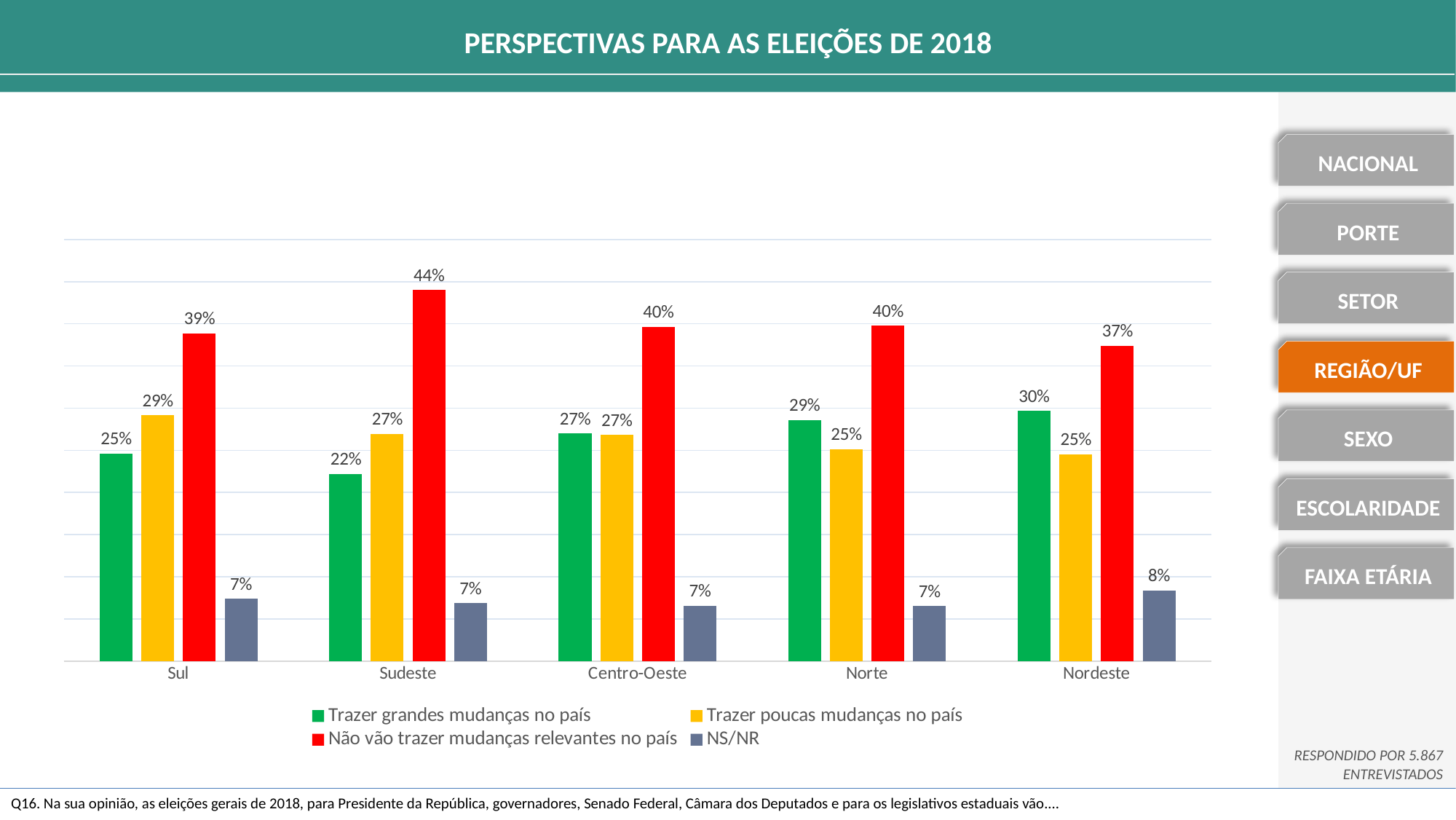
Which region has the highest value for "Não vão trazer mudanças relevantes no país"? Sudeste Which region has the lowest value for "Trazer grandes mudanças no país"? Sudeste What is the difference between the "Não vão trazer mudanças relevantes no país" value and the "Trazer grandes mudanças no país" value in Sudeste? 22% In Norte, which is larger: "Trazer grandes mudanças no país" or "Trazer poucas mudanças no país"? Trazer grandes mudanças no país Which colour represents "NS/NR" in the chart? Grey What kind of chart is shown on the slide? Bar chart What is the value for "Trazer grandes mudanças no país" in Nordeste? 30% What is the value for "Não vão trazer mudanças relevantes no país" in Sudeste? 44% How many series does the legend list? 4 What is the value for "Trazer poucas mudanças no país" in Sul? 29% What is the NS/NR value for Nordeste? 8% How many regions are shown on the x axis? 5